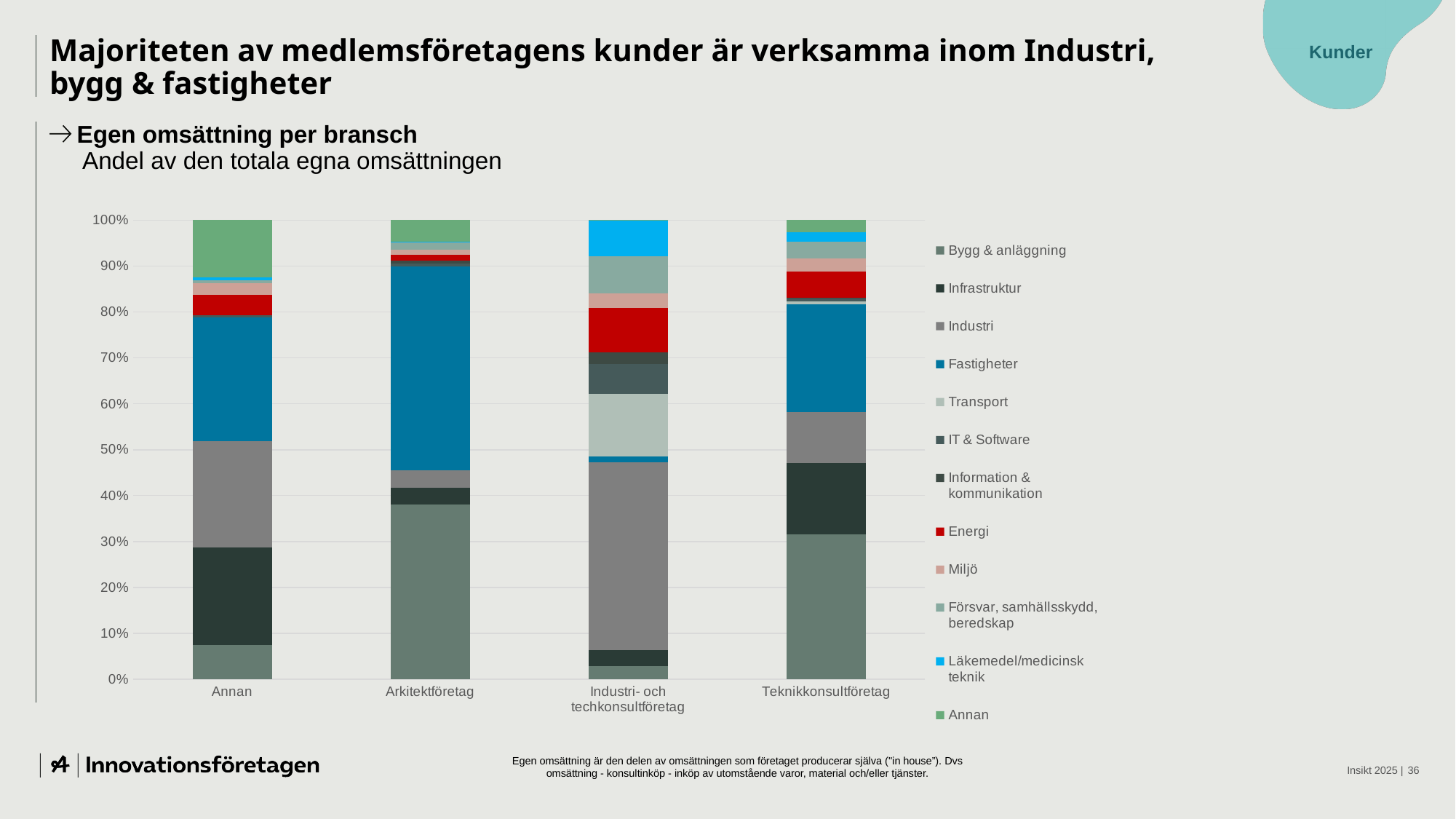
How many series does the chart's legend list? 12 Which company category has the largest Fastigheter share? Arkitektföretag Which company category has the largest Annan share? Annan Is the Bygg & anläggning share for Industri- och techkonsultföretag greater or less than 10%? less Is the Industri share for Industri- och techkonsultföretag greater or less than 30%? greater Is the Fastigheter share for Arkitektföretag greater or less than 40%? greater Which company category has the largest Läkemedel/medicinsk teknik share? Industri- och techkonsultföretag What kind of chart is shown on the slide? Stacked bar chart What is the title of the chart? Egen omsättning per bransch Is the Infrastruktur share larger for Annan or for Arkitektföretag? Annan Which legend entry is shown in red? Energi How many company categories are shown on the x axis of the chart? 4